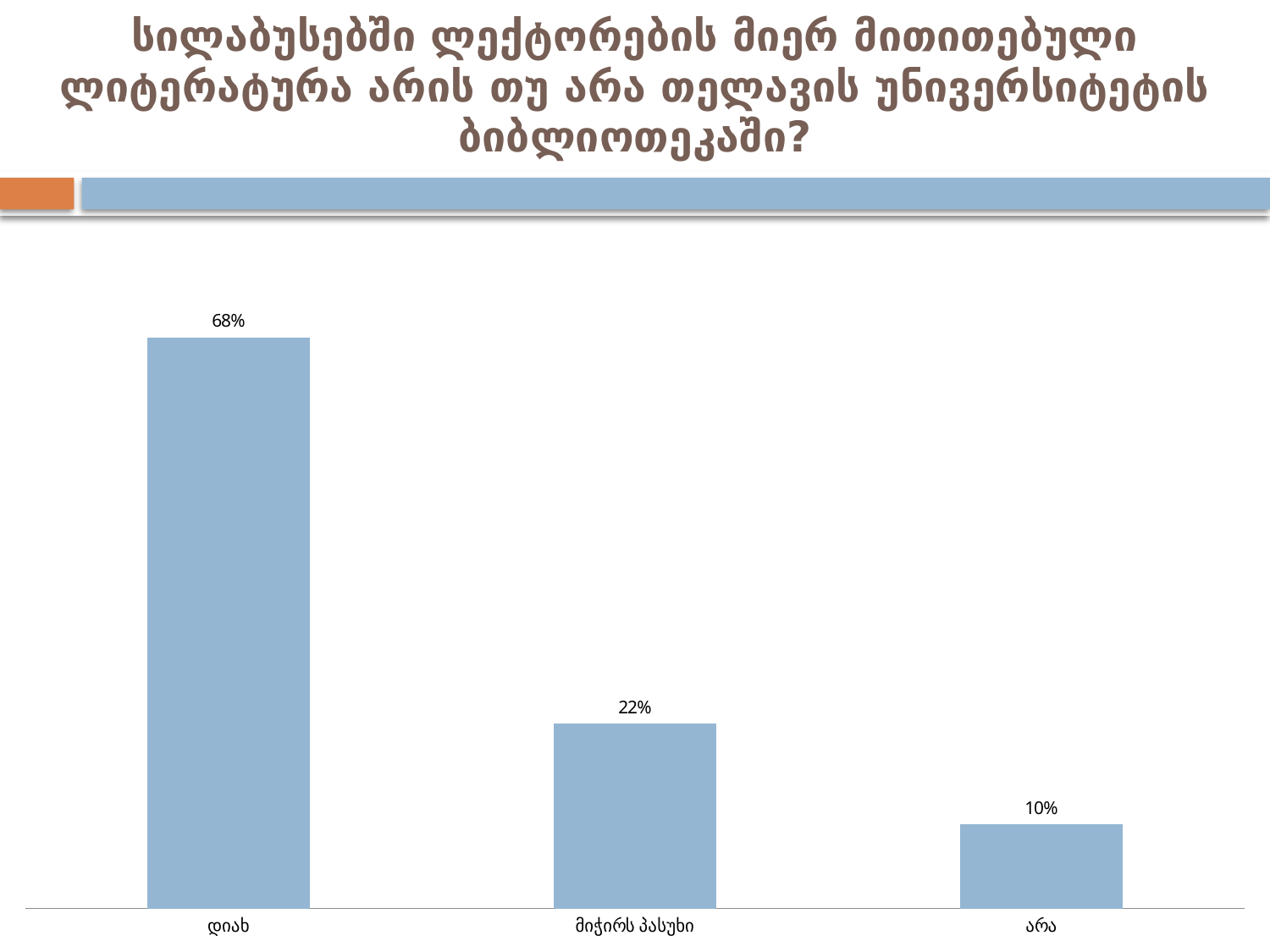
What is the difference between the values for დიახ and არა? 58% Which is larger, the value for დიახ or the value for მიჭირს პასუხი? დიახ Do the values rise or fall from left to right across the categories? fall What is the value for მიჭირს პასუხი? 22% Which category has the lowest value? არა How many categories are shown in the chart? 3 What kind of chart is shown on the slide? bar chart What is the value for არა? 10% What is the value for დიახ? 68% Which category has the highest value? დიახ What is the difference between the values for მიჭირს პასუხი and არა? 12% What colour are the bars in the chart? light blue